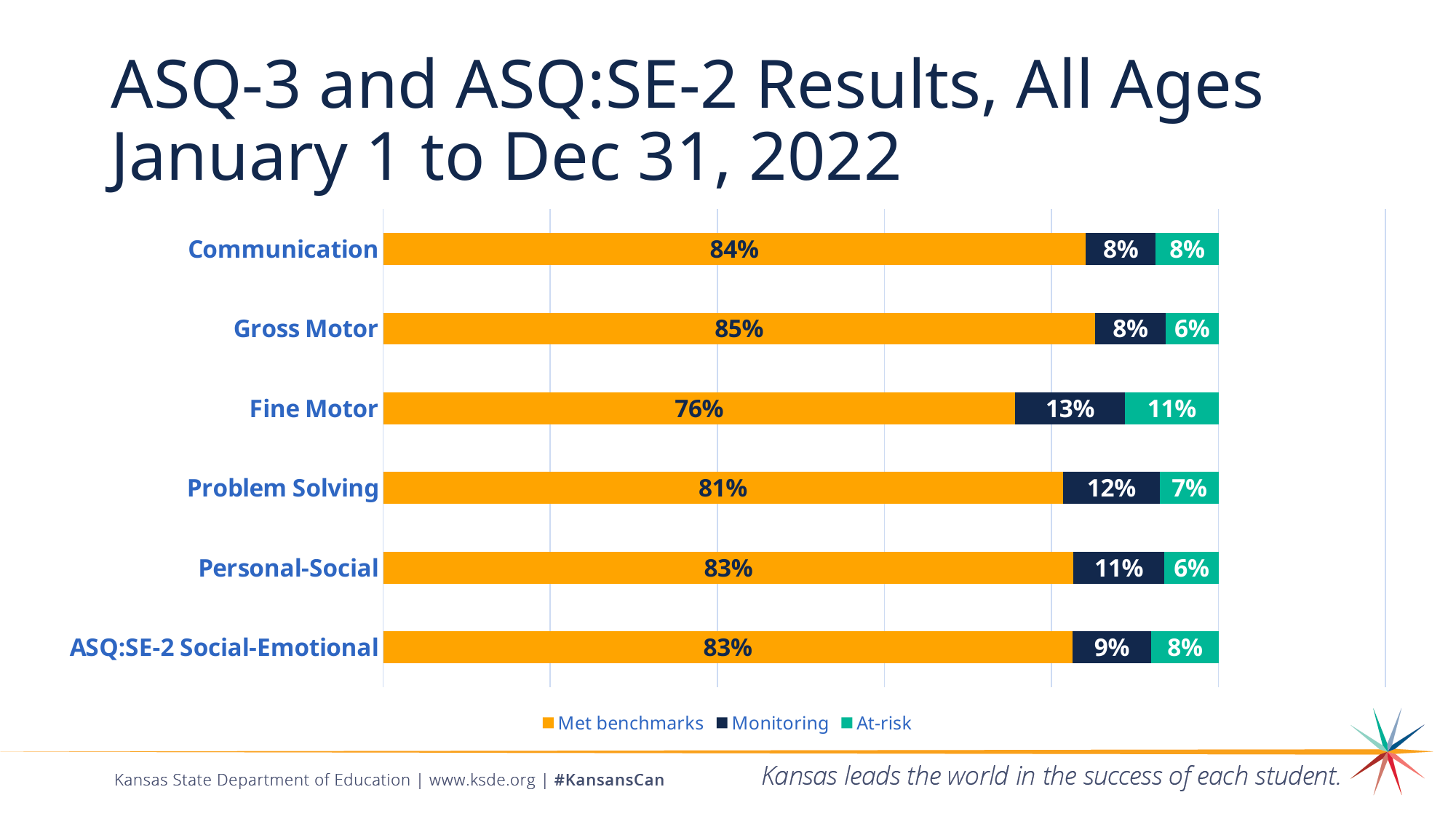
How many categories are shown on the chart? 6 Which category has the lowest Met benchmarks percentage? Fine Motor Which category has the highest At-risk percentage? Fine Motor Which is larger, the Monitoring value for Problem Solving or the Monitoring value for Personal-Social? Problem Solving What is the At-risk value for Problem Solving? 7% Which category has the highest Met benchmarks percentage? Gross Motor What kind of chart is shown on the slide? Stacked bar chart How many series does the legend list? 3 Which colour represents the At-risk series? Green What is the difference between the Met benchmarks values for Gross Motor and Fine Motor? 9% What percentage of children met benchmarks in Communication? 84% What is the Monitoring value for Fine Motor? 13%